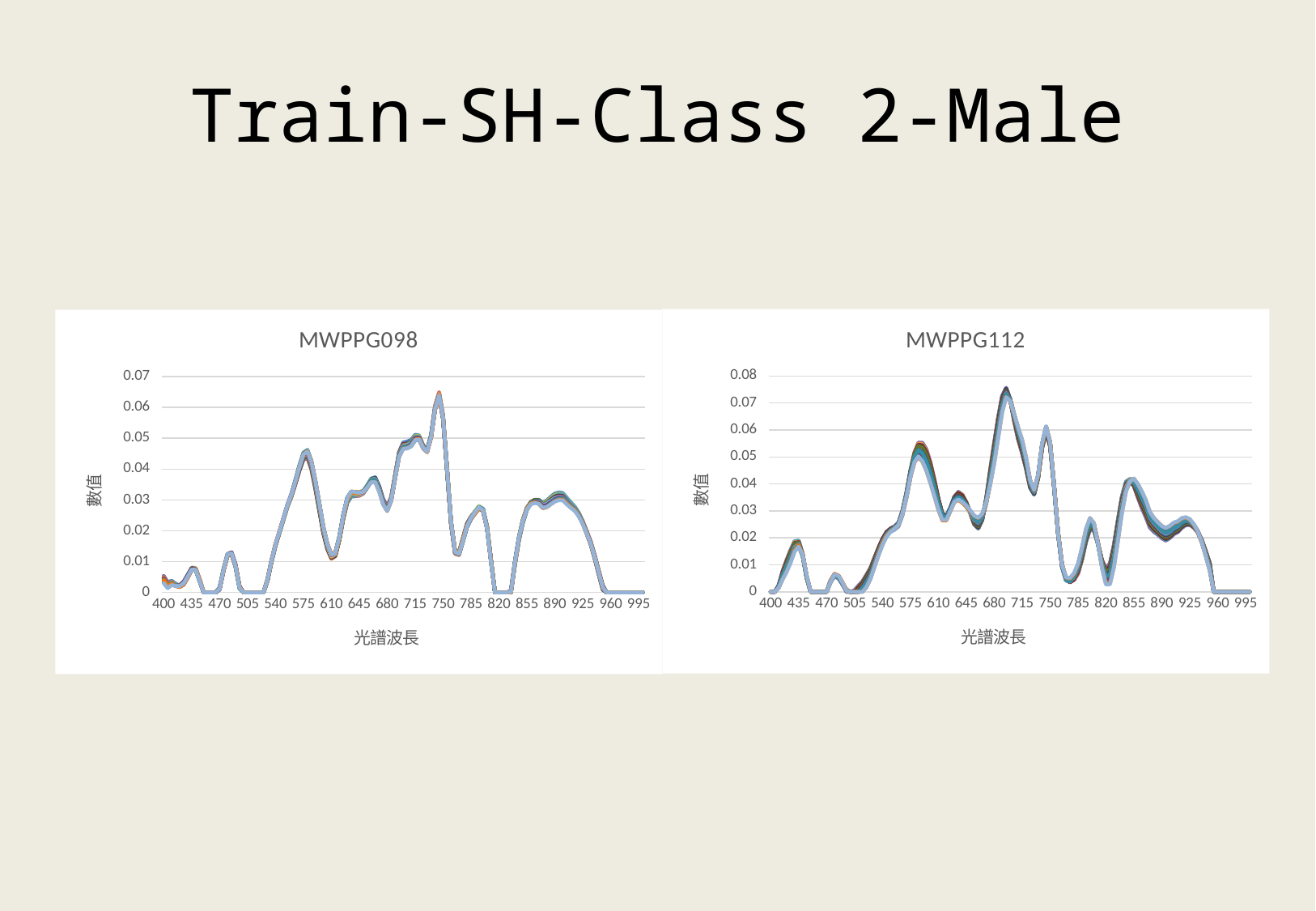
In the MWPPG098 chart, is the peak value near 750 greater or less than 0.06? greater What kind of chart is the MWPPG098 chart? line chart In the MWPPG112 chart, do the values rise or fall from 400 to 435? rise How many tick labels are shown on the x axis of the MWPPG112 chart? 18 What is the title of the chart on the right? MWPPG112 In the MWPPG112 chart, which is larger: the peak near 575 or the peak between 680 and 715? the peak between 680 and 715 In the MWPPG098 chart, which is larger: the peak near 575 or the peak near 750? the peak near 750 In the MWPPG098 chart, is the value at 820 greater or less than 0.01? less What is the x-axis label on the MWPPG098 chart? 光譜波長 In the MWPPG098 chart, do the values rise or fall from 750 to 785? fall In the MWPPG112 chart, is the highest peak (between 680 and 715) greater or less than 0.07? greater